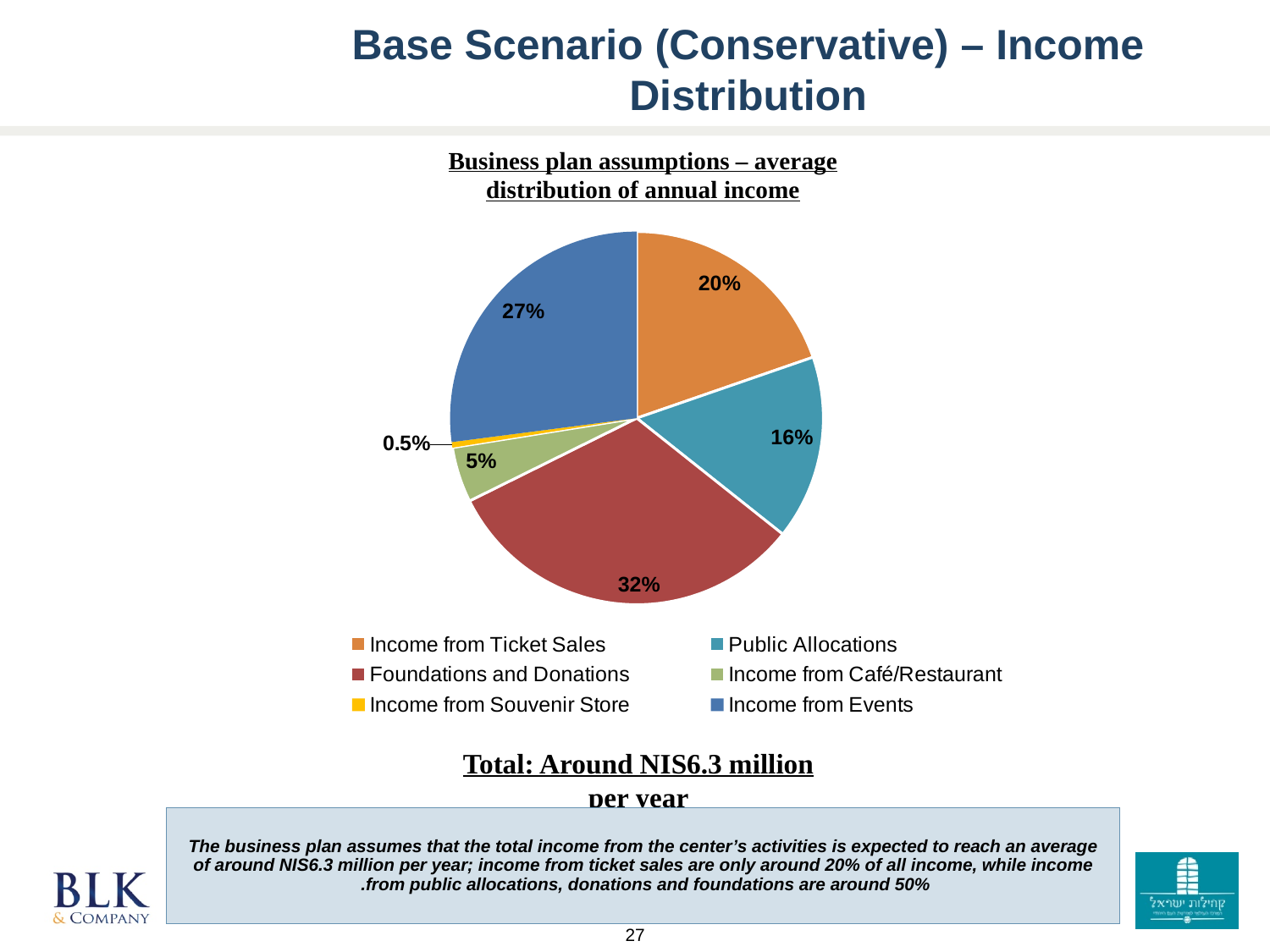
What share of annual income comes from Foundations and Donations? 32% How many income categories does the legend list? 6 What share of annual income comes from Income from Souvenir Store? 0.5% What share of annual income comes from Public Allocations? 16% What share of annual income comes from Income from Events? 27% Which income source has the smallest share of the pie? Income from Souvenir Store What share of annual income comes from Income from Ticket Sales? 20% Which is larger: the share for Income from Events or the share for Public Allocations? Income from Events Which income source has the largest share of the pie? Foundations and Donations What kind of chart is shown on the slide? Pie chart What is the title of the chart? Business plan assumptions – average distribution of annual income What is the difference in percentage points between Foundations and Donations and Income from Ticket Sales? 12